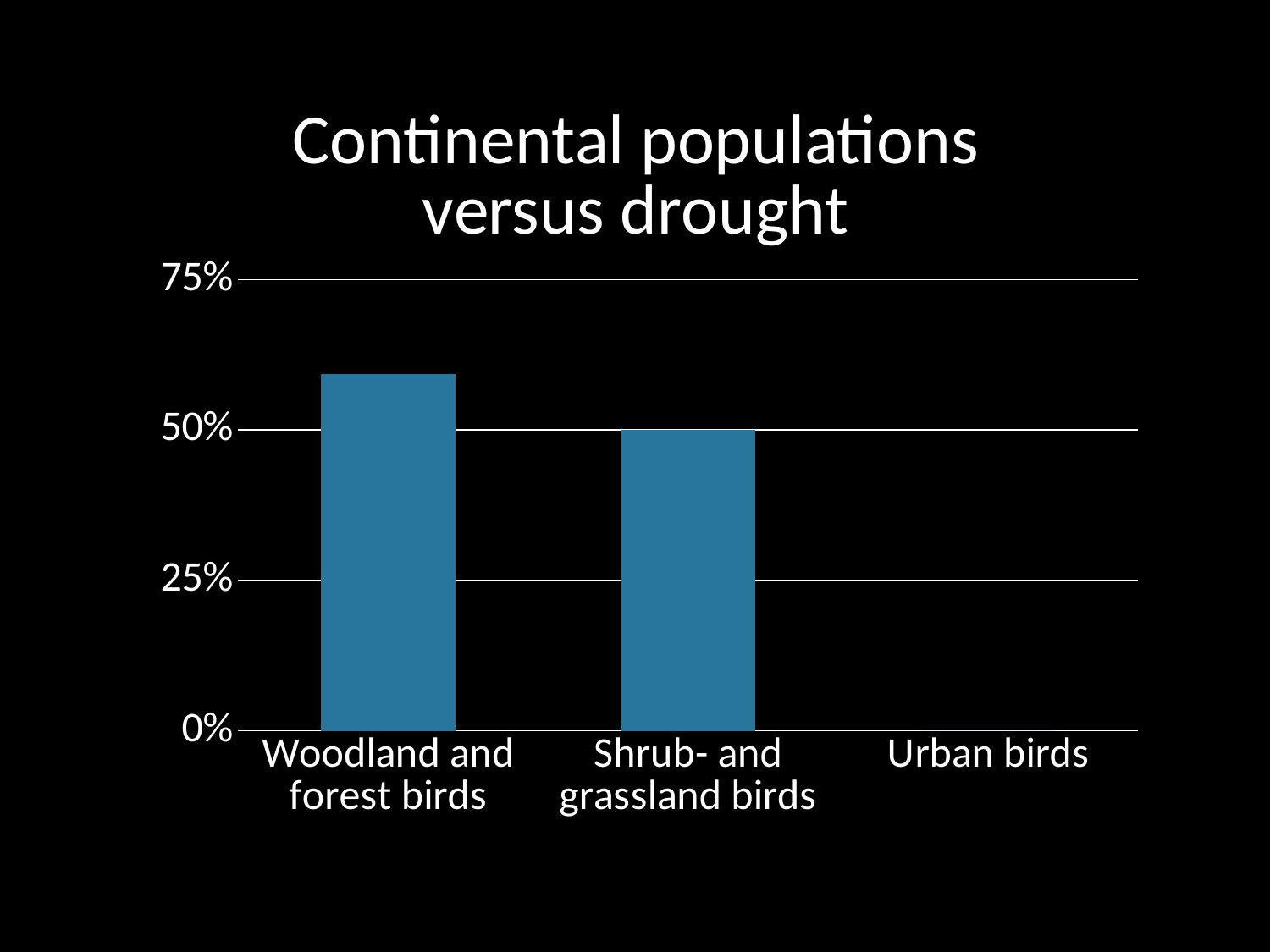
What kind of chart is shown on the slide? bar chart Which category has the lowest value in the chart? Urban birds Is the value for Woodland and forest birds greater or less than 50%? greater Do the values rise or fall moving left to right along the x axis? fall Which category has the highest value in the chart? Woodland and forest birds What is the value for Urban birds? 0% What is the value for Shrub- and grassland birds? 50% Is the value for Woodland and forest birds greater or less than 75%? less Which is larger, the value for Woodland and forest birds or the value for Shrub- and grassland birds? Woodland and forest birds What is the title of the chart? Continental populations versus drought What is the highest tick label shown on the vertical axis? 75% How many categories are shown on the x axis of the chart? 3